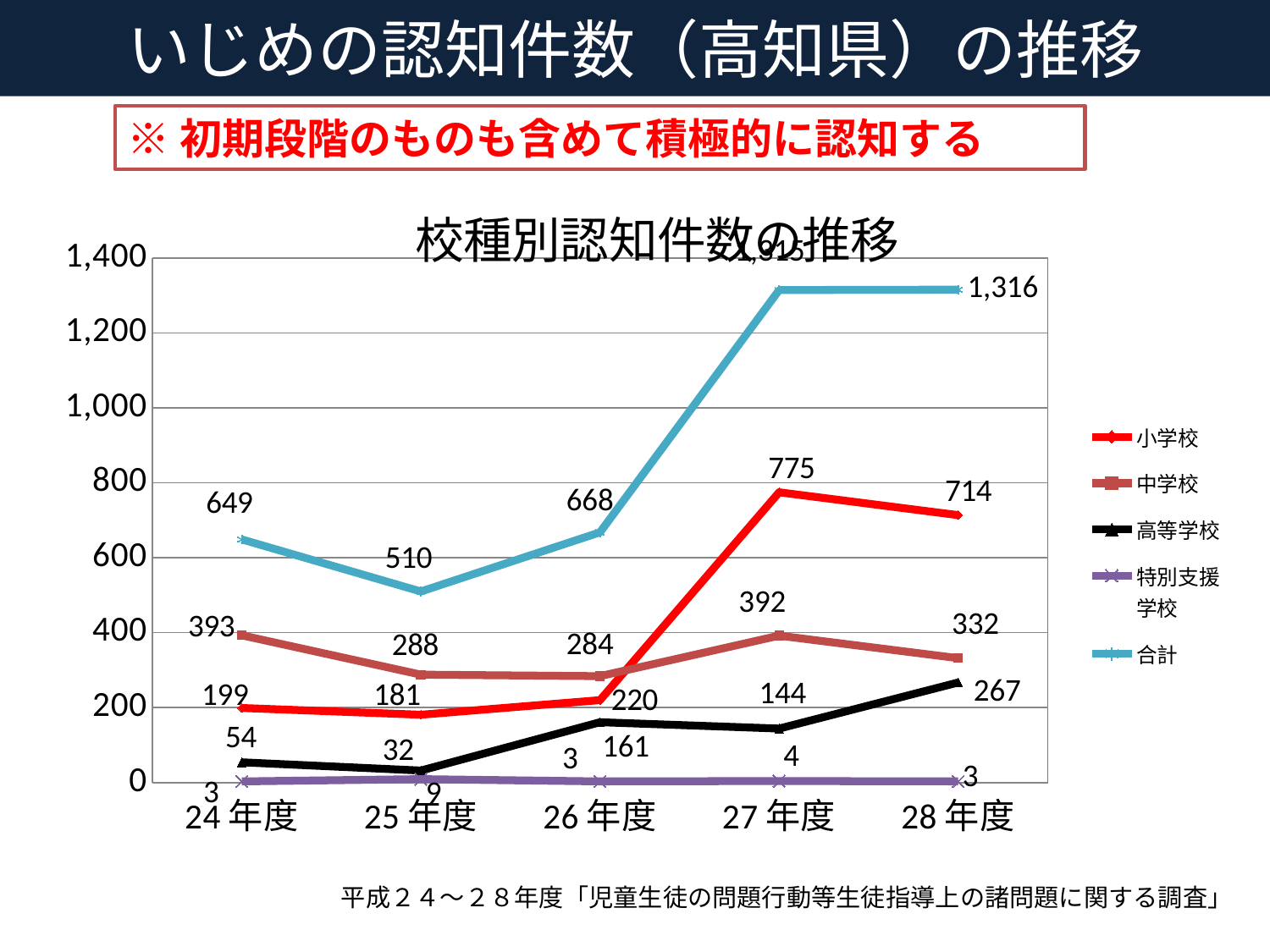
What is the difference between the 小学校 values in 27年度 and 28年度? 61 What is the title of the chart? 校種別認知件数の推移 In which fiscal year is the 小学校 value highest? 27年度 Does the 高等学校 value rise or fall from 27年度 to 28年度? rise What kind of chart is shown on the slide? line chart What is the value for 合計 in 28年度? 1,316 What is the value for 小学校 in 27年度? 775 How many fiscal years are plotted on the x axis? 5 In which fiscal year is the 合計 value lowest? 25年度 Which is larger in 26年度, the value for 中学校 or the value for 小学校? 中学校 How many series does the legend list? 5 What is the value for 高等学校 in 26年度? 161